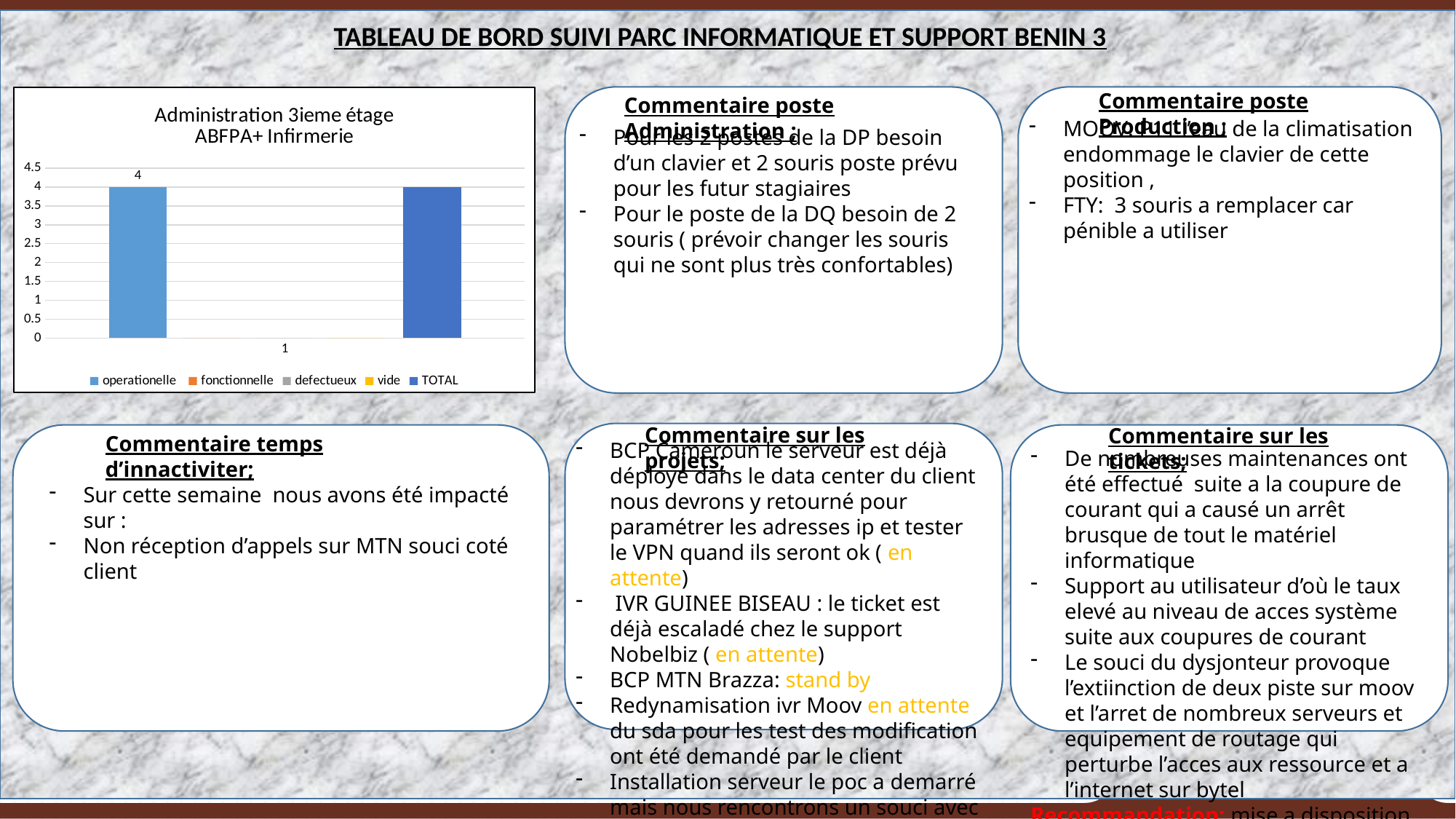
What is the highest value shown on the chart's y axis? 4.5 What is the value of the operationelle bar? 4 Is the value for operationelle greater or less than 2? greater How many series does the chart legend list? 5 What kind of chart is shown on the slide? bar chart Is the value for TOTAL greater or less than 3? greater How many categories are shown on the x axis of the chart? 1 What is the title of the chart? Administration 3ieme étage ABFPA+ Infirmerie What is the value of the TOTAL bar? 4 Which series are listed in the chart legend? operationelle, fonctionnelle, defectueux, vide, TOTAL